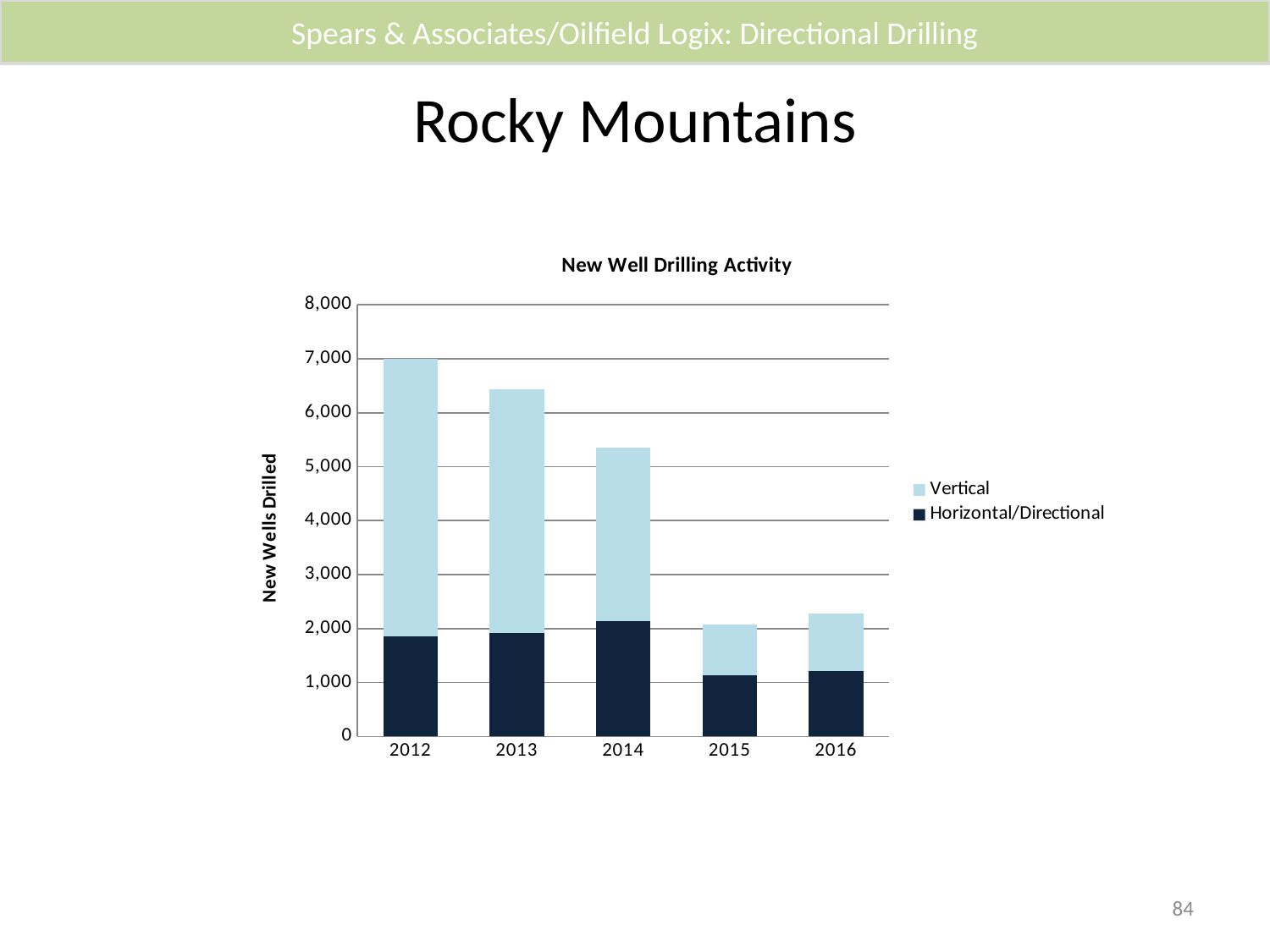
Is the Horizontal/Directional value for 2014 greater or less than 2,000? greater Do the total new wells drilled generally rise or fall from 2012 to 2015? fall Which year has a larger total of new wells drilled, 2014 or 2016? 2014 How many years are shown on the x axis of the chart? 5 Is the total number of new wells drilled in 2013 greater or less than 6,000? greater How many series does the chart legend list? 2 Is the Horizontal/Directional value for 2015 greater or less than 2,000? less Which year has the highest total number of new wells drilled? 2012 What kind of chart is shown on the slide? Stacked bar chart What is the title of the chart? New Well Drilling Activity Which year has the lowest total number of new wells drilled? 2015